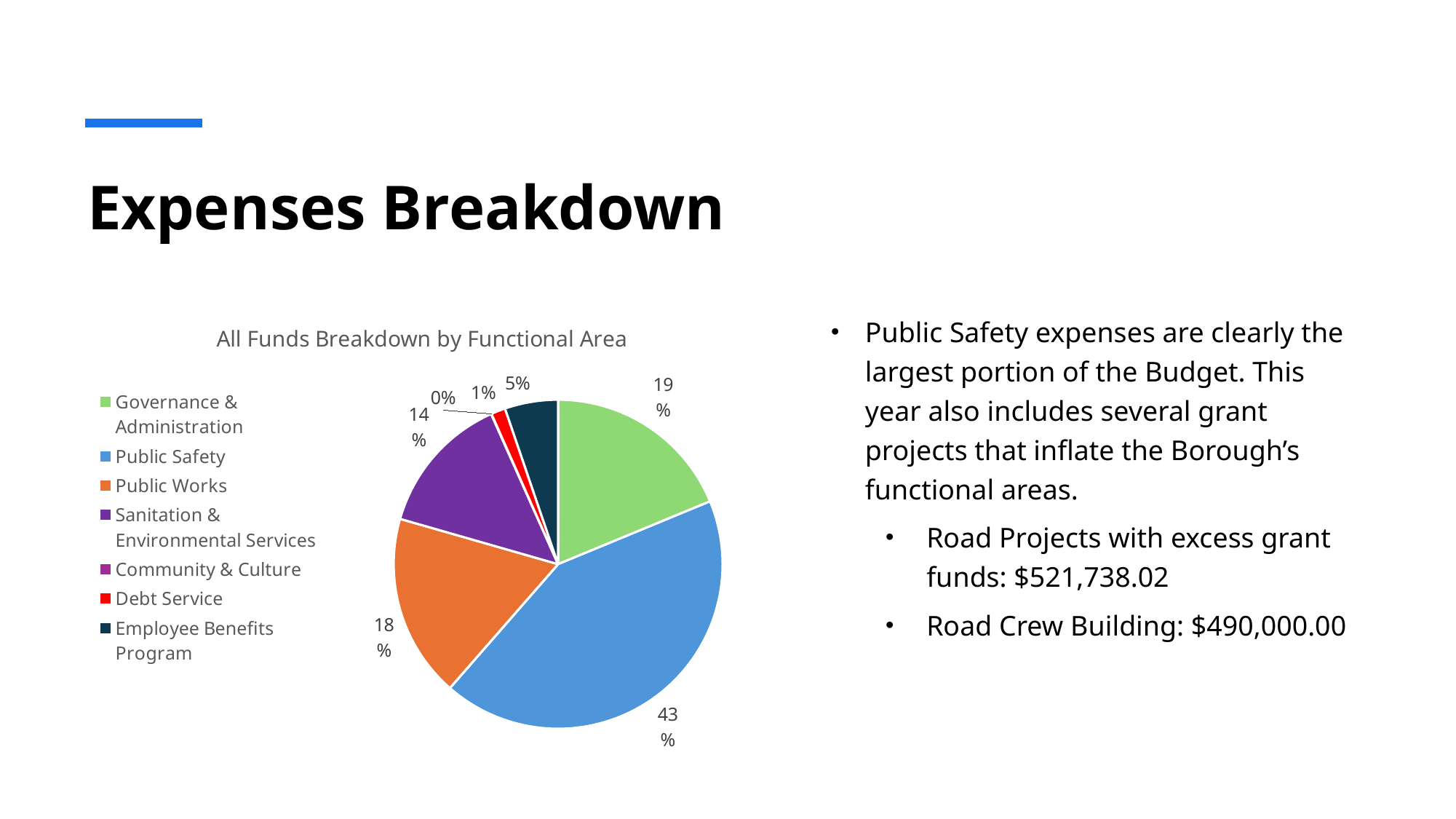
What type of chart is shown on the slide? pie chart What is the difference in percentage points between Public Safety and Governance & Administration? 24 How many functional areas does the legend list? 7 What share of the pie does Employee Benefits Program represent? 5% What share of the pie does Debt Service represent? 1% Which functional area has the smallest share of the pie? Community & Culture What is the chart's title? All Funds Breakdown by Functional Area Which functional area has the largest share of the pie? Public Safety What share of the pie does Public Safety represent? 43%